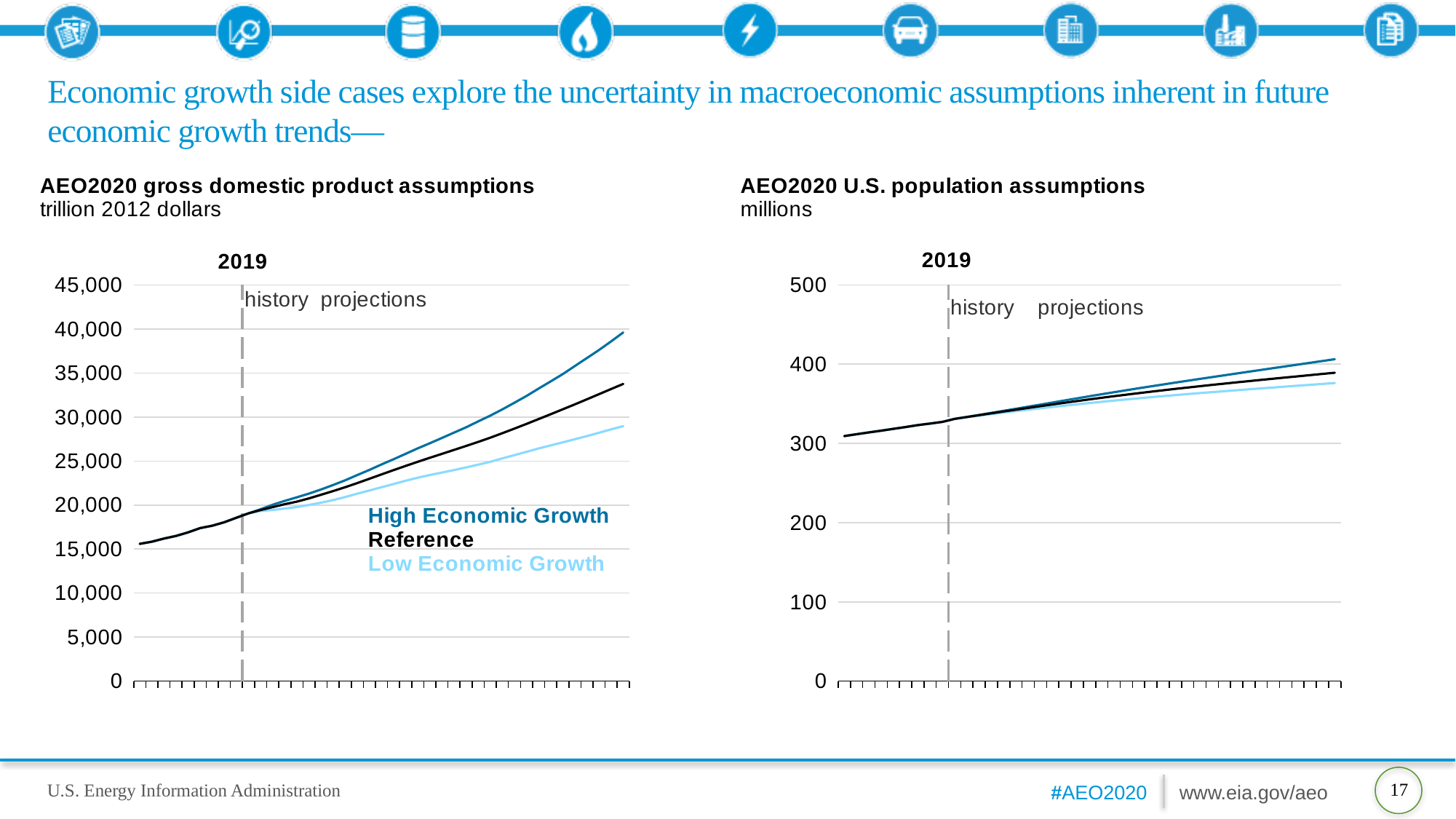
What unit is shown under the title of the AEO2020 gross domestic product assumptions chart? trillion 2012 dollars In the AEO2020 U.S. population assumptions chart, do the values rise or fall along the x axis? rise In the AEO2020 gross domestic product assumptions chart, is the High Economic Growth value at the end of the projection period greater or less than 35,000? greater In the AEO2020 gross domestic product assumptions chart, do the values rise or fall along the x axis? rise In the AEO2020 gross domestic product assumptions chart, which series is higher at the end of the projection period, High Economic Growth or Low Economic Growth? High Economic Growth In the AEO2020 U.S. population assumptions chart, is the value at the start of the history period greater or less than 300? greater In the AEO2020 gross domestic product assumptions chart, is the Low Economic Growth value at the end of the projection period greater or less than 30,000? less What year does the dashed vertical line mark in the AEO2020 U.S. population assumptions chart? 2019 How many series does the legend of the AEO2020 gross domestic product assumptions chart list? 3 In the AEO2020 gross domestic product assumptions chart, which series is highest at the end of the projection period? High Economic Growth What kind of chart is the AEO2020 gross domestic product assumptions chart? line chart